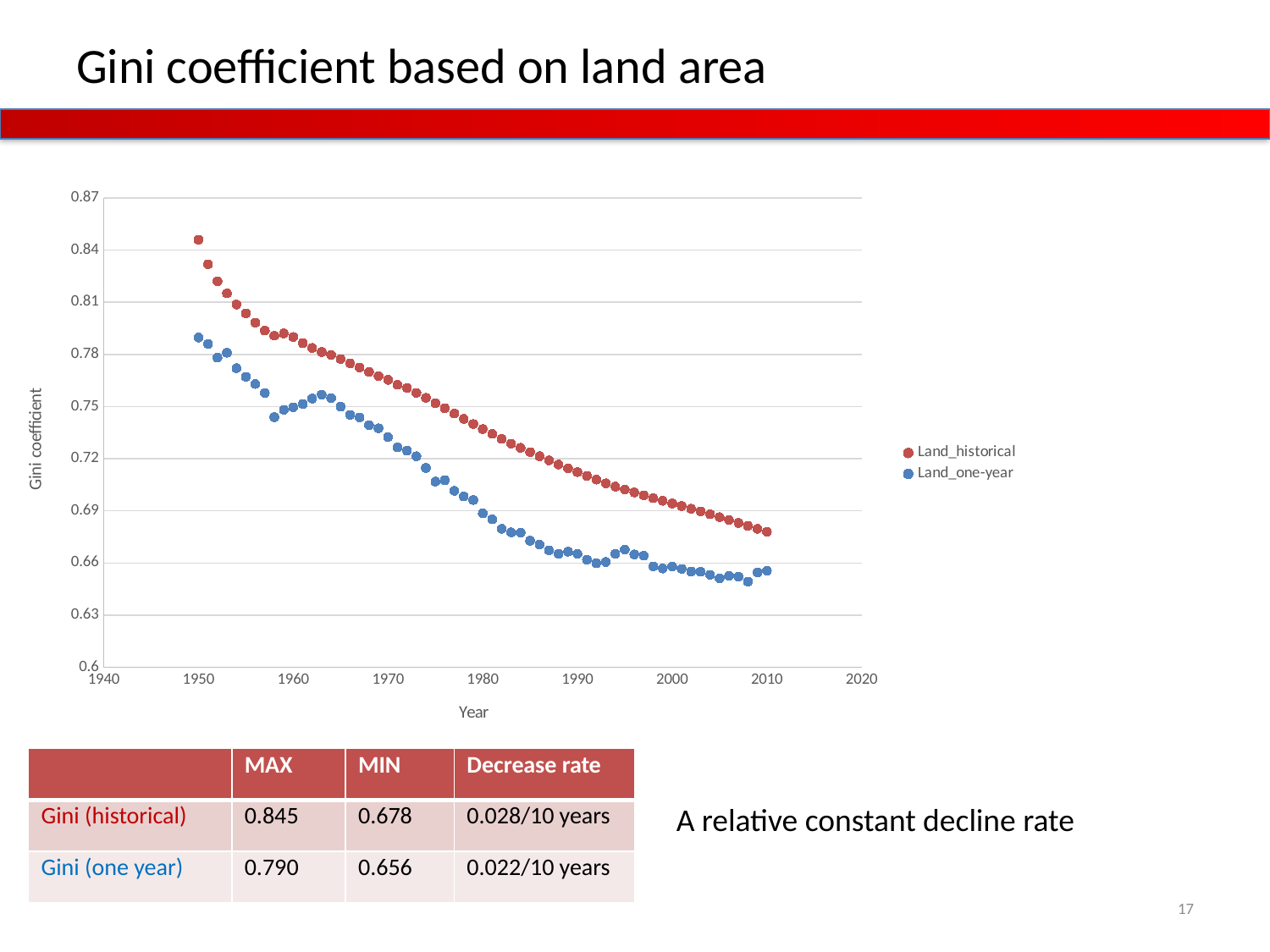
What is the title of the chart's x axis? Year How many series does the chart legend list? 2 Do the Land_historical values rise or fall as the year increases? fall Which series has the higher value in 1950, Land_historical or Land_one-year? Land_historical Is the Land_historical value in 1950 greater or less than 0.84? greater Is the Land_one-year value in 1970 greater or less than 0.75? less What kind of chart is shown on the slide? scatter chart Is the Land_one-year value in 2010 greater or less than 0.66? less Do the Land_one-year values rise or fall overall from 1950 to 2010? fall Which two series are listed in the chart legend? Land_historical and Land_one-year Which series has the lower value in 2010, Land_historical or Land_one-year? Land_one-year